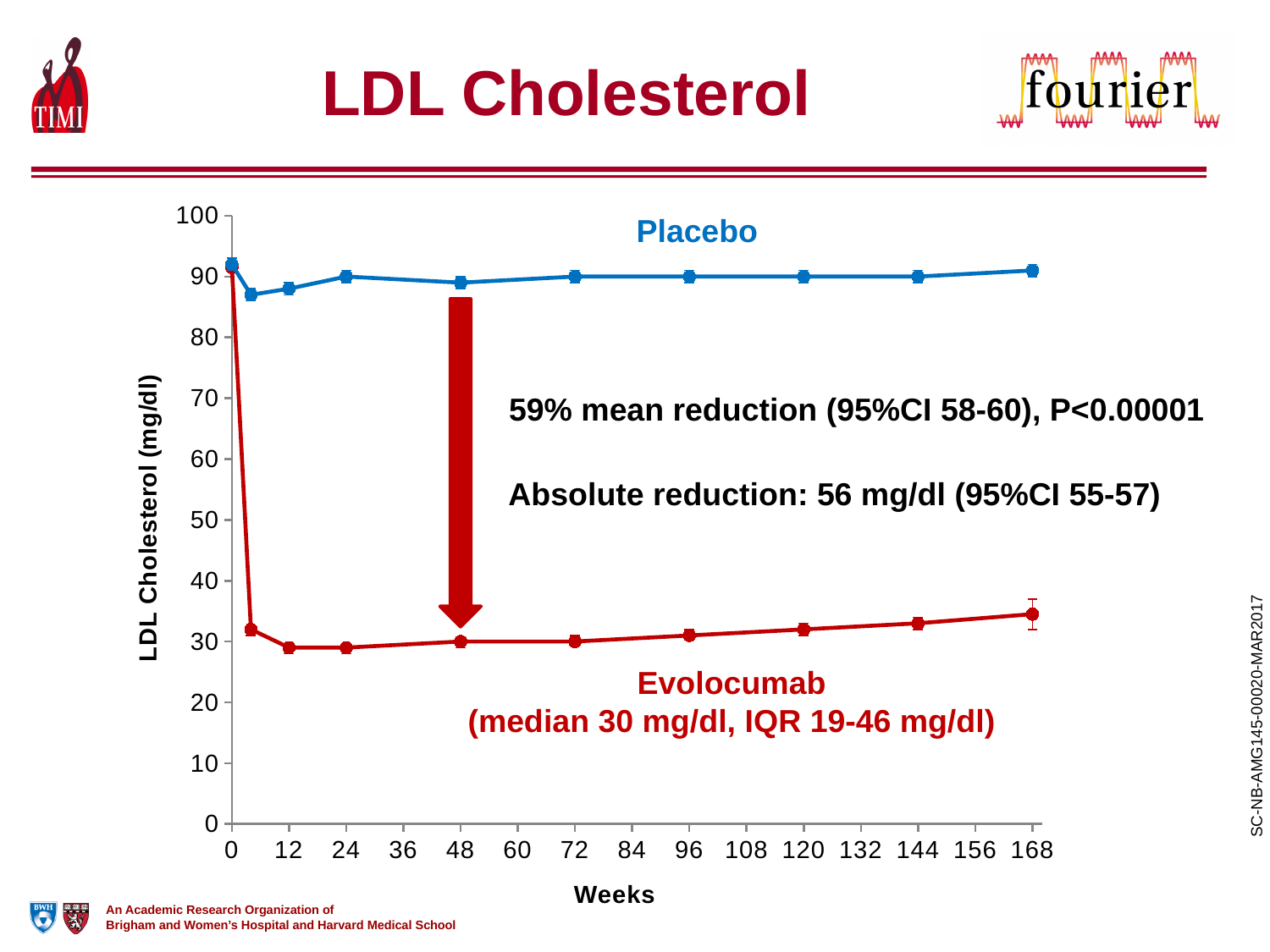
What absolute reduction in LDL cholesterol is stated on the chart? 56 mg/dl Is the Placebo value at week 48 greater or less than 80? greater Is the Evolocumab value at week 48 greater or less than 40? less What median LDL cholesterol value is given for the Evolocumab group? 30 mg/dl How many series are plotted on the chart? 2 How many data points are plotted for the Placebo series? 10 What kind of chart is shown on the slide? line chart At week 96, which series has the higher LDL cholesterol value, Placebo or Evolocumab? Placebo Is the Evolocumab value at week 168 greater or less than 30? greater Does the Evolocumab line rise or fall between week 12 and week 168? rise What is the label on the y axis of the chart? LDL Cholesterol (mg/dl) What is the mean percentage reduction in LDL cholesterol stated on the chart? 59%